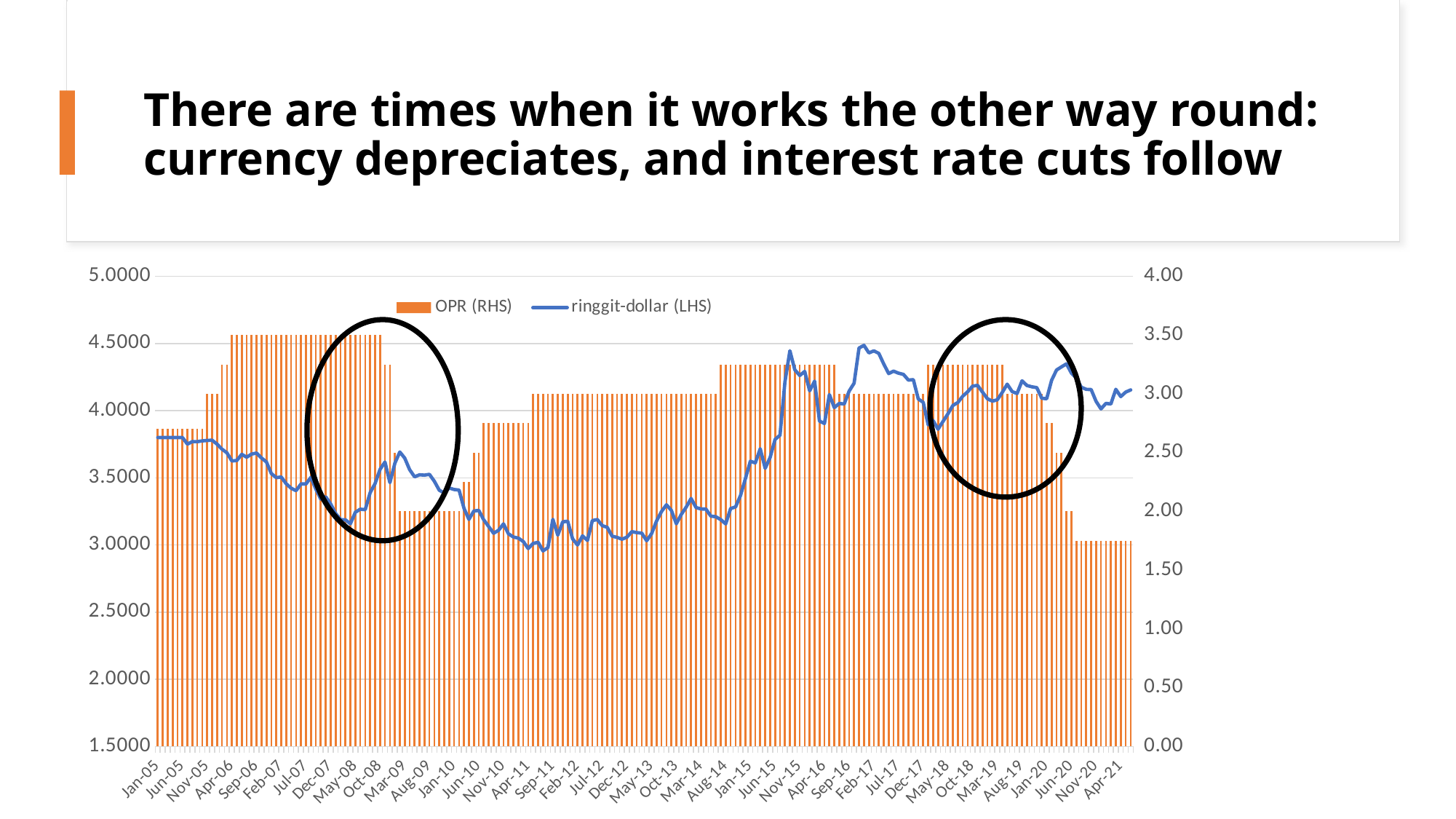
What are the two series named in the legend? OPR (RHS) and ringgit-dollar (LHS) Is the OPR value for Sep-06 greater or less than 3.00 on the right-hand axis? greater Do the OPR bars rise or fall between Jan-20 and Apr-21? fall How many series does the legend list? 2 Which is larger, the OPR value for Sep-06 or the OPR value for Apr-21? Sep-06 Does the ringgit-dollar line rise or fall between Jan-05 and Apr-11? fall Is the OPR value for Apr-21 greater or less than 2.00 on the right-hand axis? less What kind of chart is this? Combined bar and line chart Is the ringgit-dollar value for Nov-15 greater or less than 4.0000 on the left-hand axis? greater Which is larger, the ringgit-dollar value for Nov-15 or the ringgit-dollar value for Apr-11? Nov-15 Which series is plotted as orange bars? OPR (RHS)